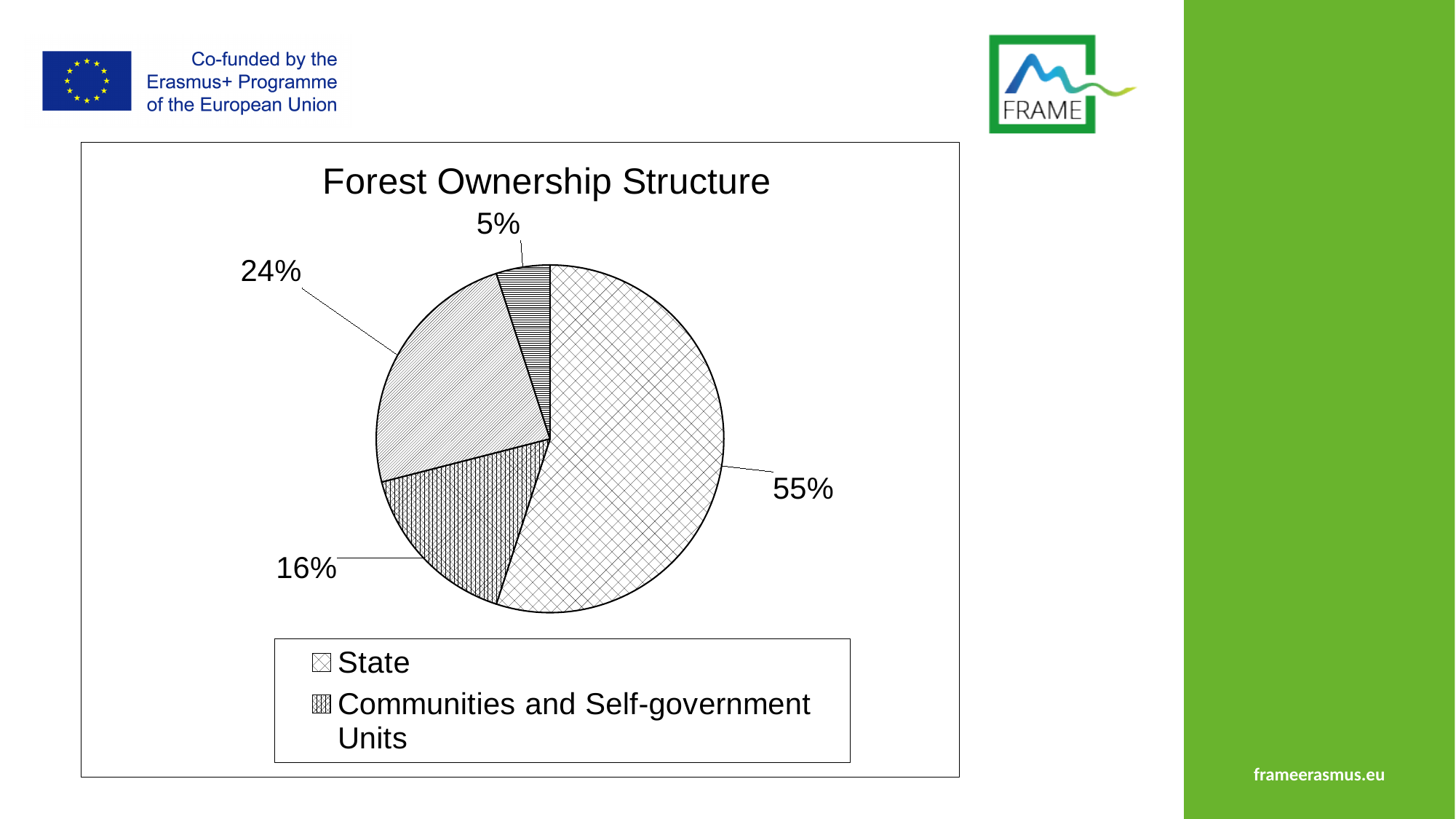
What percentage of the pie does the Communities and Self-government Units slice represent? 16% By how many percentage points is the State slice larger than the Communities and Self-government Units slice? 39 percentage points What kind of chart is shown on the slide? pie chart Is the State slice greater or less than half of the pie? greater How many slices does the pie chart have? 4 What is the smallest percentage shown on the pie chart? 5% What is the largest percentage shown on the pie chart? 55% Which legend entry corresponds to the largest slice of the pie? State Which is larger, the State slice or the Communities and Self-government Units slice? State How many entries does the chart legend list? 2 What percentage of the pie does the State slice represent? 55% What is the title of the chart? Forest Ownership Structure